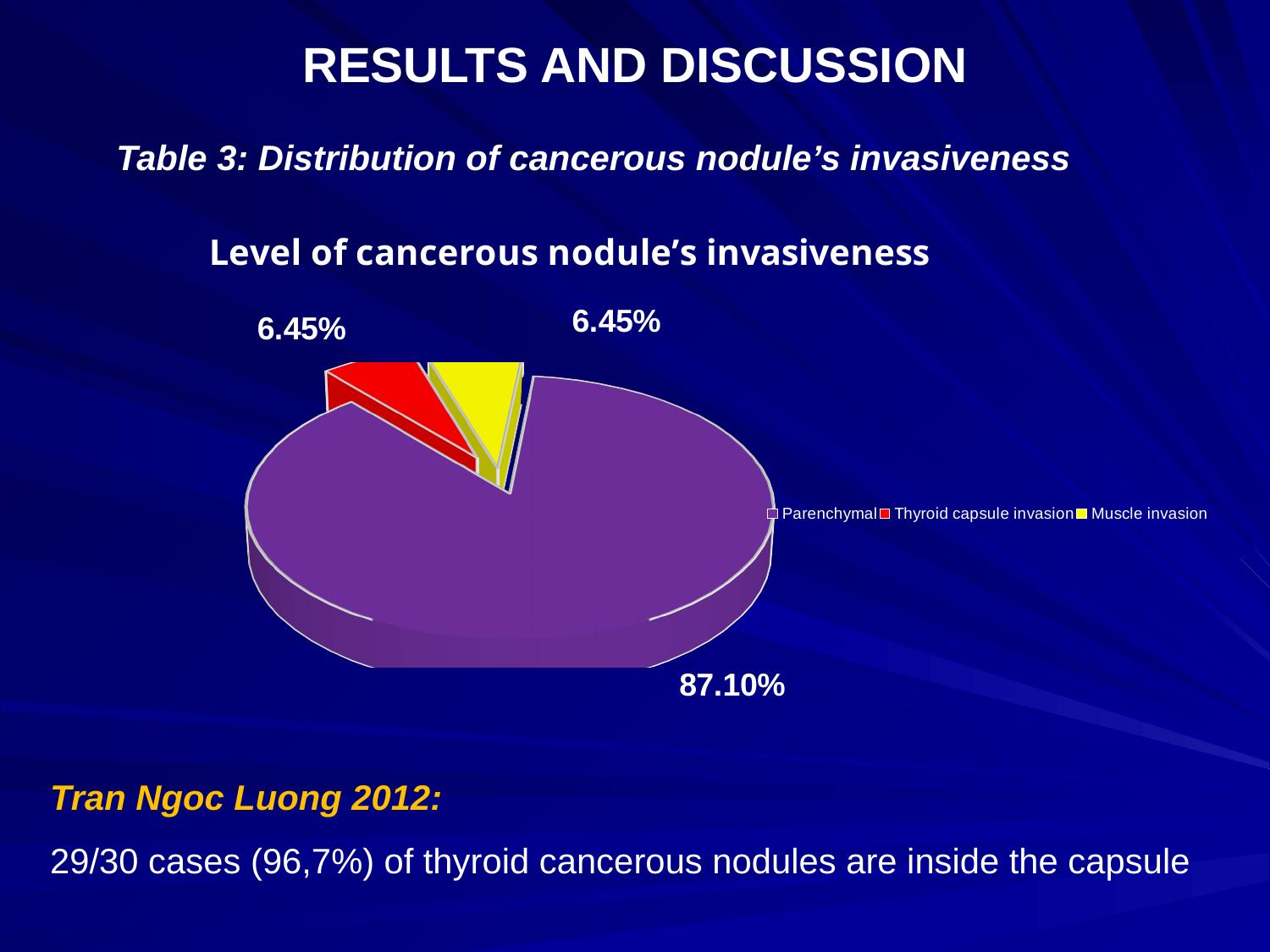
What percentage of the pie chart is Parenchymal? 87.10% What percentage of the pie chart is Muscle invasion? 6.45% What kind of chart is shown on the slide? Pie chart What is the difference between the Parenchymal share and the Thyroid capsule invasion share? 80.65% How many slices does the pie chart have? 3 What share of the pie does the Parenchymal slice represent? 87.10% What percentage of the pie chart is Thyroid capsule invasion? 6.45% How many entries does the legend of the pie chart list? 3 What is the title of the pie chart? Level of cancerous nodule's invasiveness Which category has the largest slice in the pie chart? Parenchymal Which colour represents Thyroid capsule invasion in the pie chart? Red Which is larger in the pie chart, Parenchymal or Muscle invasion? Parenchymal